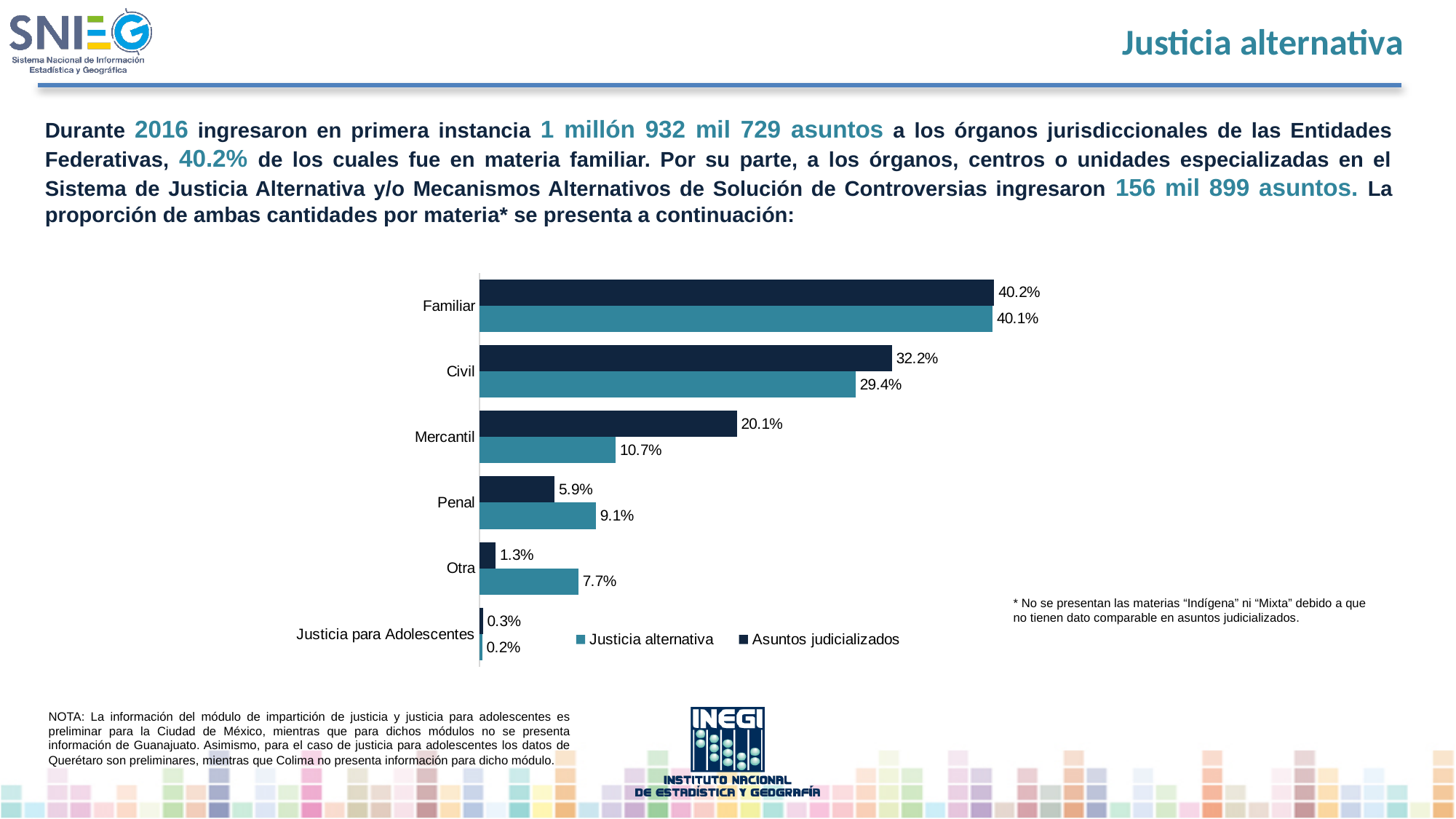
What is the value for Civil in the Asuntos judicializados series? 32.2% Which colour represents the Justicia alternativa series? Teal (light blue) What is the value for Mercantil in the Justicia alternativa series? 10.7% How many categories are shown on the chart? 6 What is the value for Otra in the Asuntos judicializados series? 1.3% For Penal, which series has the larger value: Justicia alternativa or Asuntos judicializados? Justicia alternativa Which category has the lowest value in the Asuntos judicializados series? Justicia para Adolescentes How many series does the legend list? 2 What is the difference between the Asuntos judicializados and Justicia alternativa values for Mercantil? 9.4% What kind of chart is shown on the slide? Bar chart What is the value for Penal in the Justicia alternativa series? 9.1% Which category has the highest value in the Justicia alternativa series? Familiar